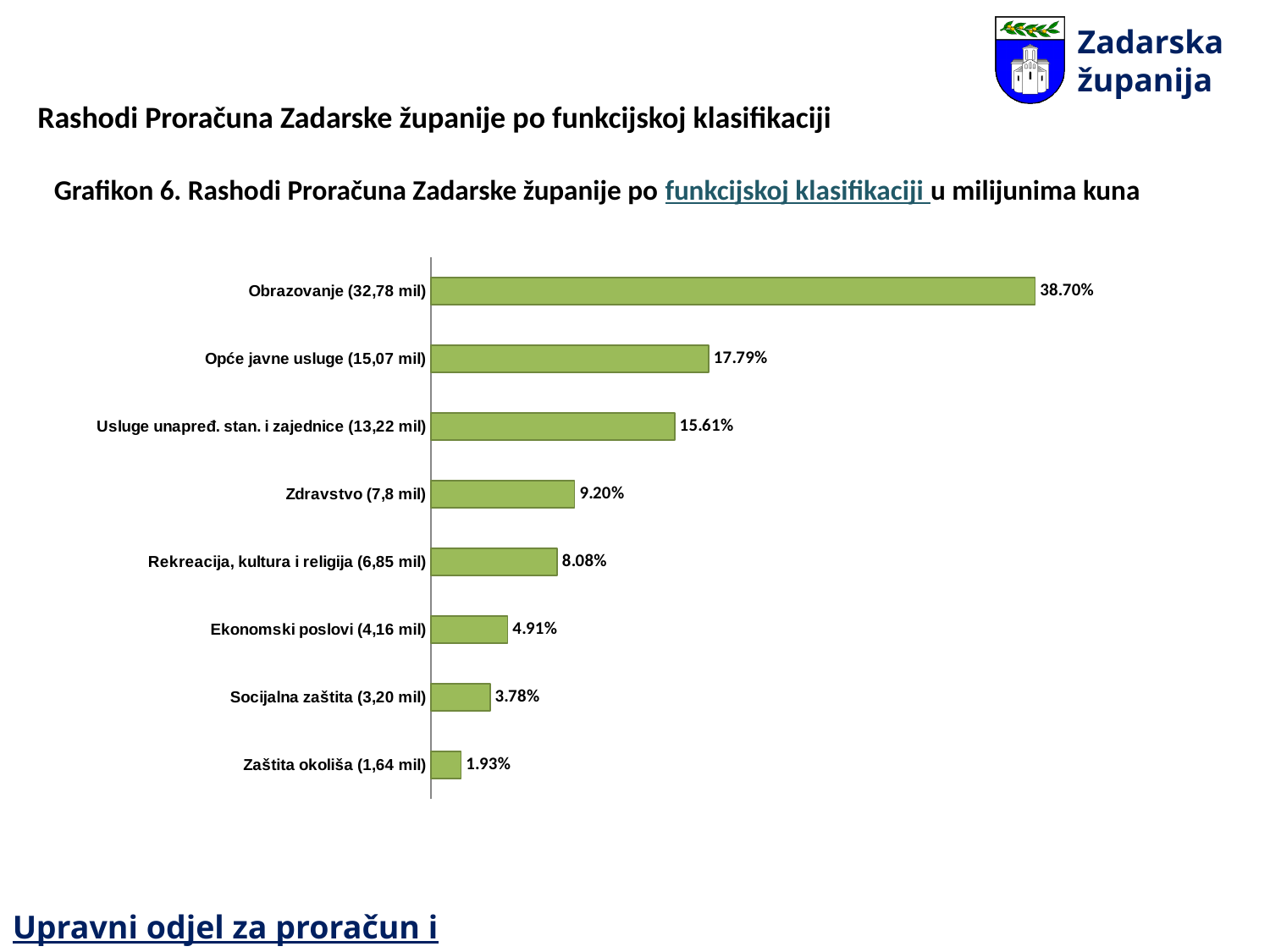
How many categories are shown in the chart? 8 Which category has the lowest percentage? Zaštita okoliša (1,64 mil) What percentage is shown for Obrazovanje (32,78 mil)? 38.70% What percentage is shown for Usluge unapređ. stan. i zajednice (13,22 mil)? 15.61% What percentage is shown for Socijalna zaštita (3,20 mil)? 3.78% What is the title of the chart? Grafikon 6. Rashodi Proračuna Zadarske županije po funkcijskoj klasifikaciji u milijunima kuna What is the difference in percentage points between Rekreacija, kultura i religija (6,85 mil) and Ekonomski poslovi (4,16 mil)? 3.17 What percentage is shown for Zdravstvo (7,8 mil)? 9.20% What is the difference in percentage points between Obrazovanje (32,78 mil) and Opće javne usluge (15,07 mil)? 20.91 What kind of chart is shown on the slide? Bar chart Which has a larger percentage, Zdravstvo (7,8 mil) or Rekreacija, kultura i religija (6,85 mil)? Zdravstvo (7,8 mil) Which category has the highest percentage? Obrazovanje (32,78 mil)